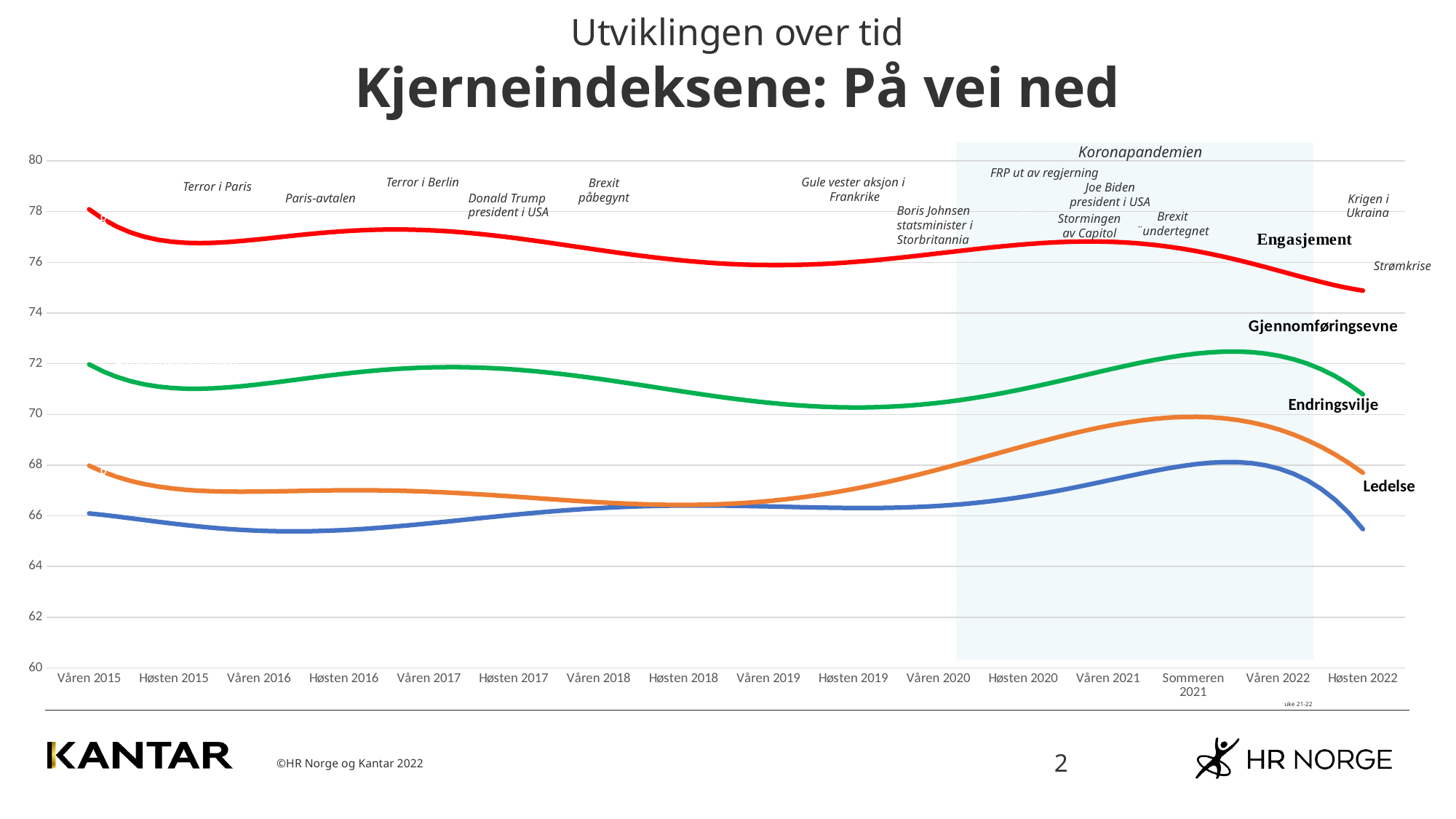
Is the value for Engasjement at Høsten 2022 greater or less than 76? less Which is larger at Høsten 2022, Endringsvilje or Ledelse? Endringsvilje How many time points are shown on the x axis of the chart? 16 What label is given to the shaded period on the chart? Koronapandemien Does the Engasjement series rise or fall from Våren 2022 to Høsten 2022? fall Is the value for Endringsvilje at Høsten 2022 greater or less than 66? greater What kind of chart is shown on the slide? line chart Which series has the lowest value at Høsten 2022? Ledelse How many series are plotted on the chart? 4 Which series has the highest values across the whole chart? Engasjement Is the value for Ledelse at Våren 2016 greater or less than 66? less